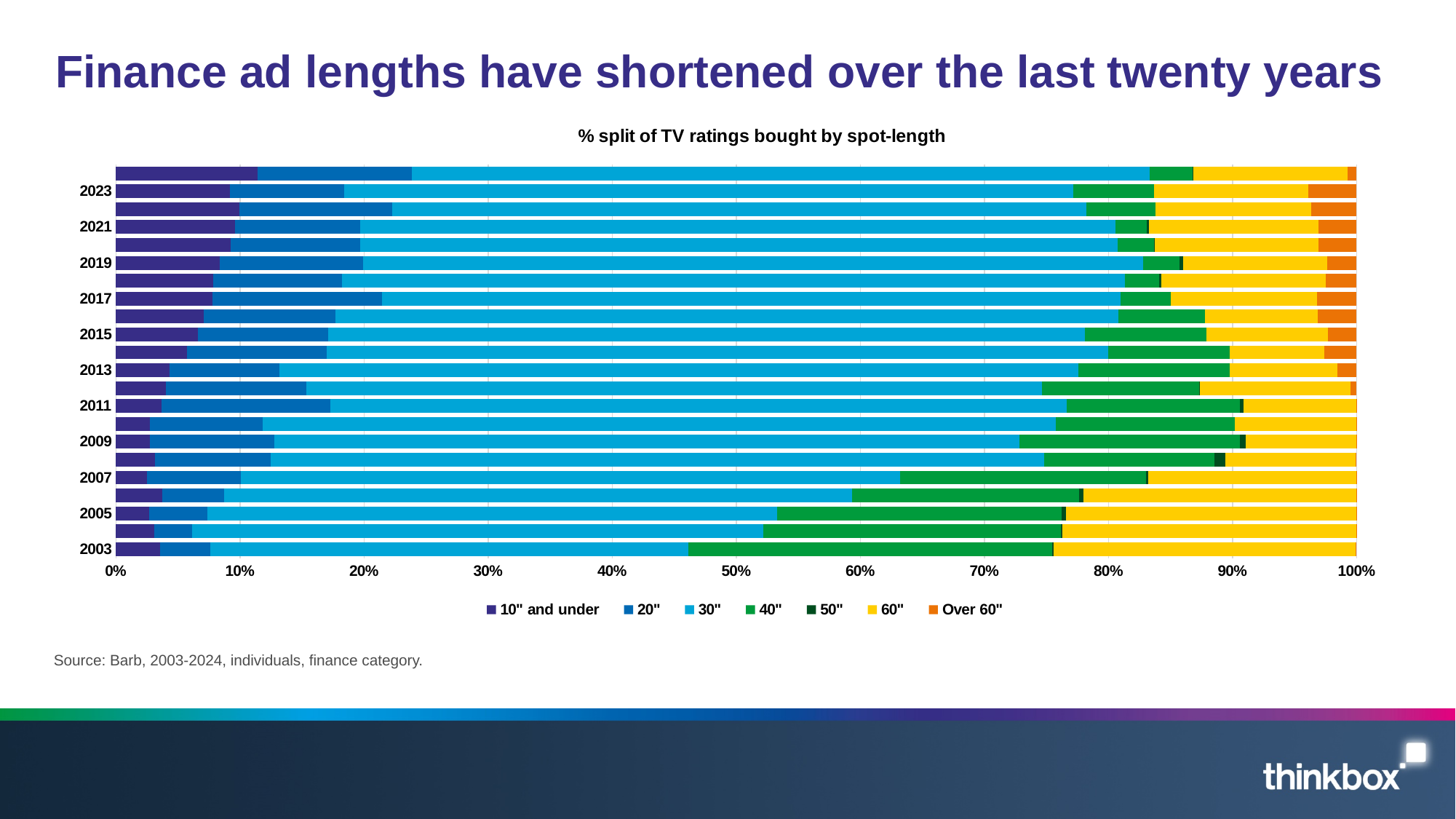
What kind of chart is shown on the slide? Stacked bar chart Which year has the larger 10" and under share, 2003 or 2023? 2023 Which labelled year has the largest 40" share? 2003 What is the chart's subtitle above the plot area? % split of TV ratings bought by spot-length Which legend entry is shown in yellow? 60" Is the 30" share for 2003 greater or less than 50%? less Is the 40" share for 2003 greater or less than 20%? greater How many series does the legend list? 7 How many years are labelled on the vertical axis? 11 Is the 30" share for 2023 greater or less than 50%? greater Which labelled year has the smallest 30" share? 2003 Does the 40" share rise or fall from 2003 to 2023? fall